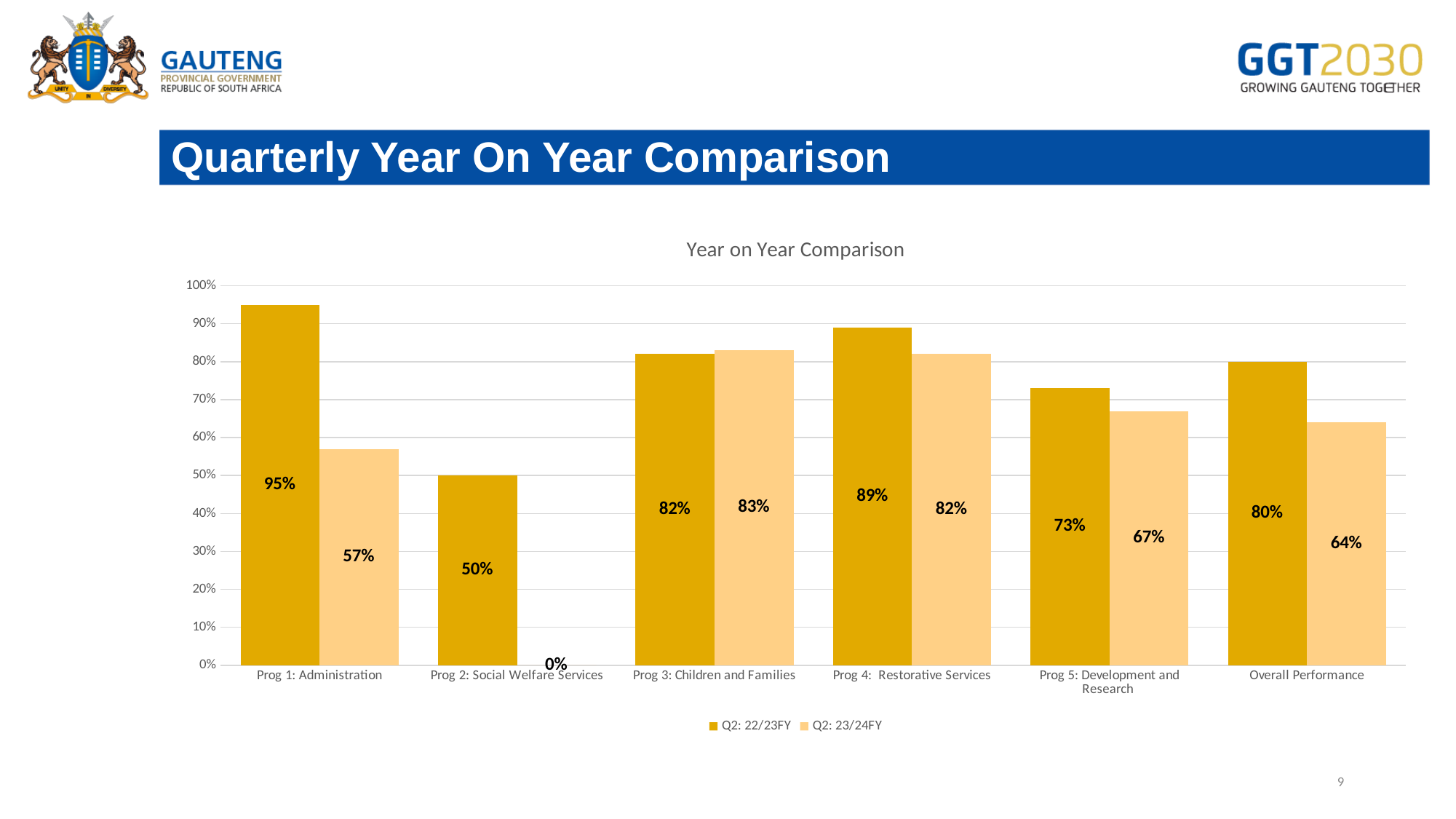
What is the title of the chart? Year on Year Comparison What is the difference between the Q2: 22/23FY and Q2: 23/24FY values for Prog 1: Administration? 38% How many categories are shown on the x axis? 6 Which category has the highest Q2: 22/23FY value? Prog 1: Administration Is the Q2: 23/24FY value for Overall Performance greater or less than 70%? less Which category has the lowest Q2: 23/24FY value? Prog 2: Social Welfare Services What is the Q2: 22/23FY value for Prog 1: Administration? 95% What is the Q2: 23/24FY value for Prog 5: Development and Research? 67% How many series does the legend list? 2 What kind of chart is shown on the slide? bar chart Which is larger for Prog 4: Restorative Services, the Q2: 22/23FY value or the Q2: 23/24FY value? Q2: 22/23FY What is the Q2: 23/24FY value for Prog 2: Social Welfare Services? 0%